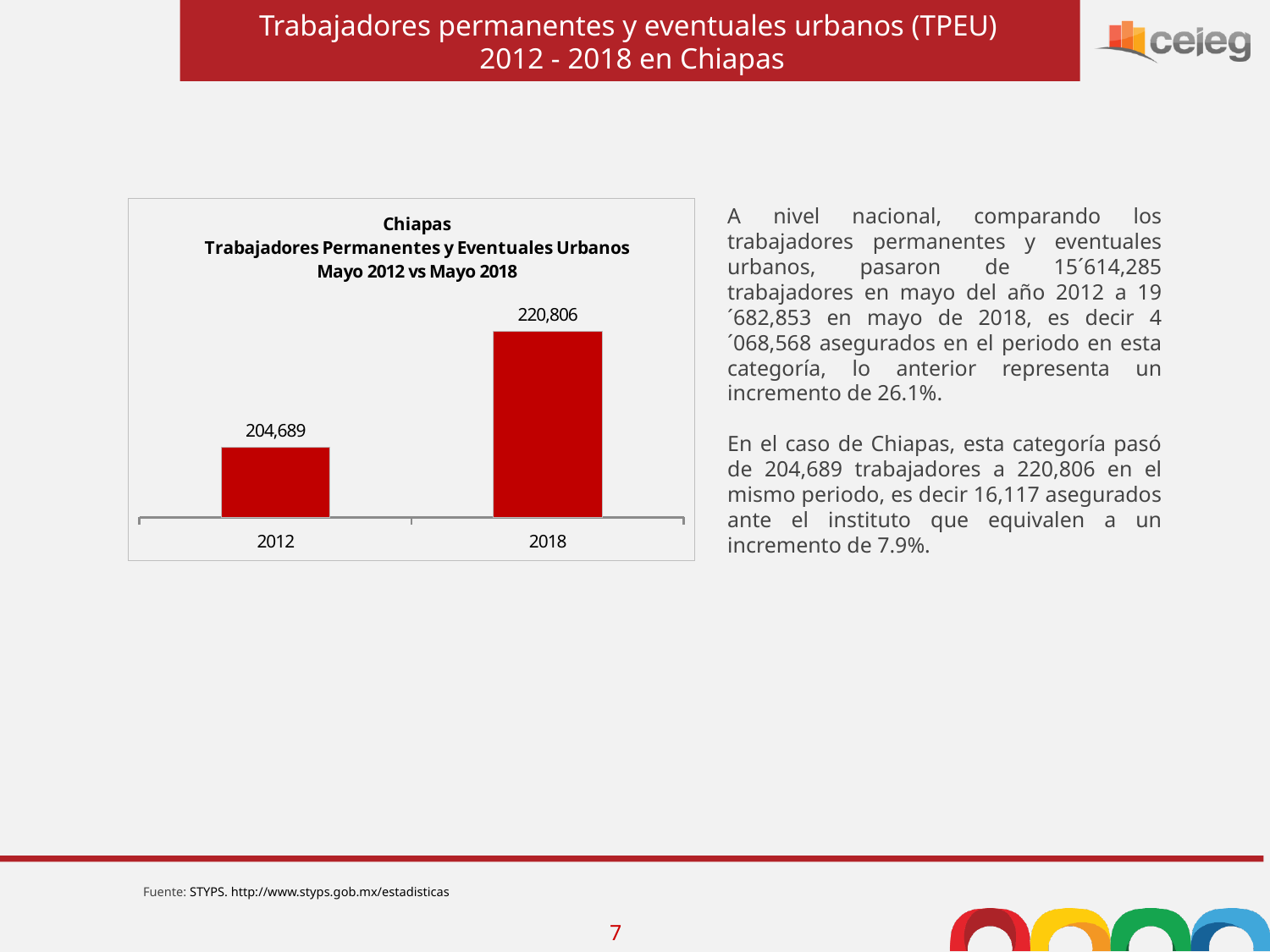
What is the value for 2012 in the chart? 204,689 Do the values rise or fall from 2012 to 2018 in the chart? rise What is the difference between the 2018 and 2012 values in the chart? 16,117 What is the value for 2018 in the chart? 220,806 What is the first line of the chart's title? Chiapas What kind of chart is shown on the slide? bar chart Is the value for 2018 larger or smaller than the value for 2012? larger How many categories are shown on the x axis of the chart? 2 Which year has the higher value in the chart? 2018 What colour are the bars in the chart? red Which year has the lower value in the chart? 2012